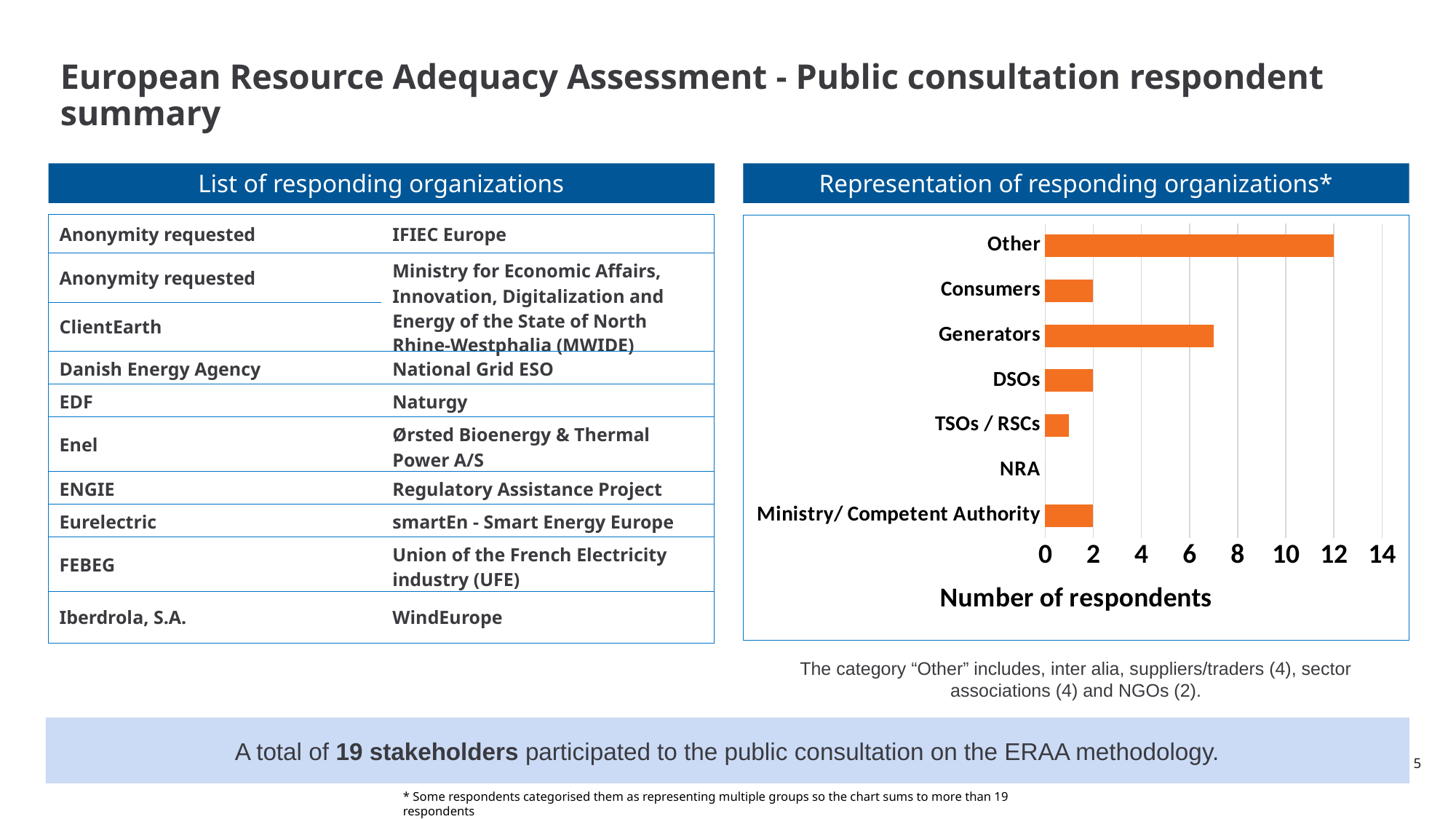
Which has more respondents, Generators or Consumers? Generators Is the value for TSOs / RSCs greater or less than 2? less Which category has the highest number of respondents? Other What is the number of respondents for the "Other" category? 12 What is the number of respondents for DSOs? 2 Is the value for Generators greater or less than 6? greater What is the number of respondents for Consumers? 2 How many categories are shown on the y axis of the bar chart? 7 What is the difference in respondents between "Other" and "Ministry/ Competent Authority"? 10 What kind of chart is shown under "Representation of responding organizations*"? bar chart What is the title of the x axis of the bar chart? Number of respondents Which category has the lowest number of respondents? NRA